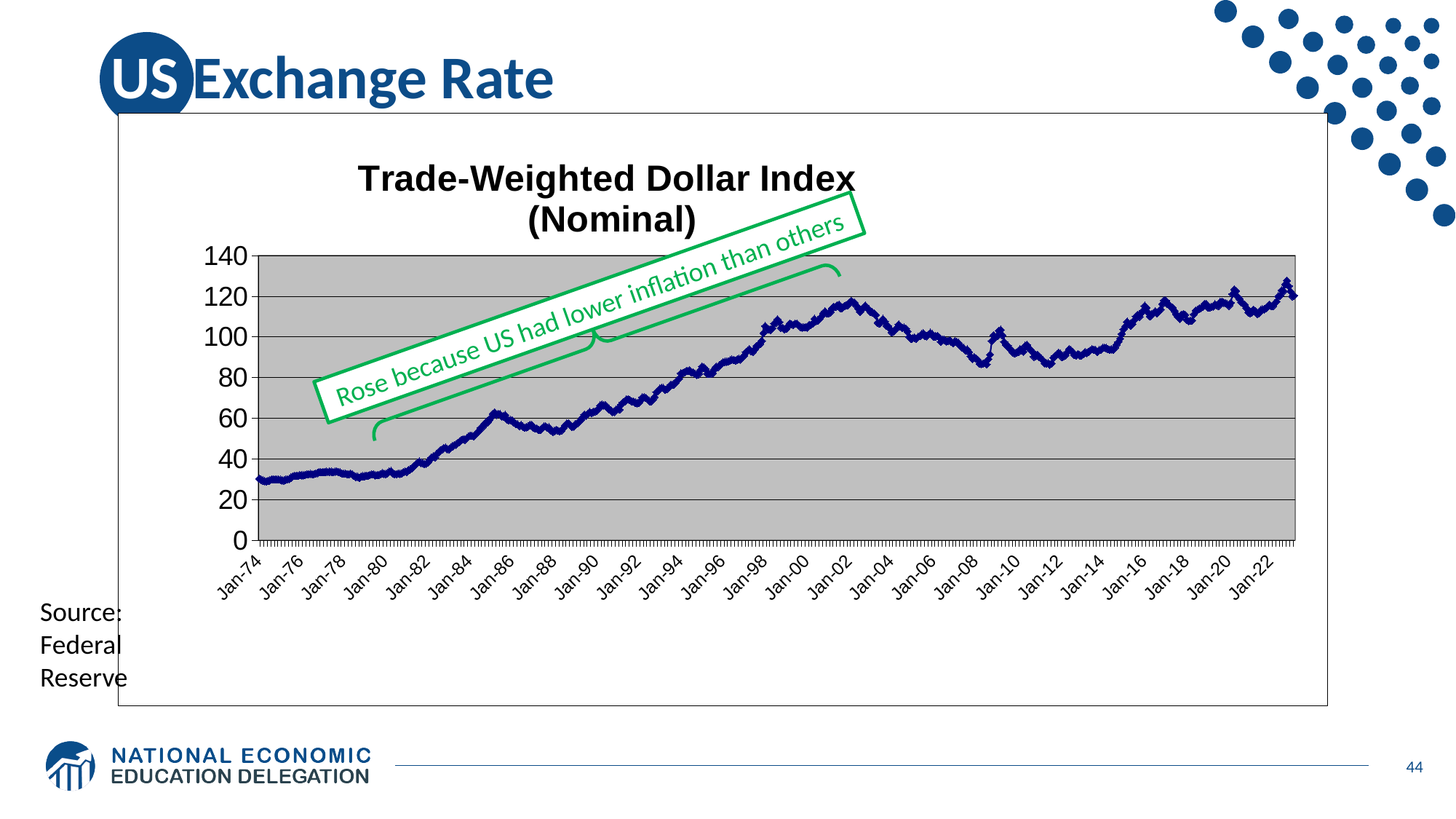
Is the value of the index at Jan-02 greater or less than 100? greater How many date labels are shown on the x axis? 25 What does the green annotation on the chart say? Rose because US had lower inflation than others What is the title of the chart? Trade-Weighted Dollar Index (Nominal) Is the value of the index at Jan-74 greater or less than 40? less Overall, does the Trade-Weighted Dollar Index rise or fall from Jan-74 to the end of the series? Rise What kind of chart is shown on the slide? Line chart Is the value of the index at Jan-80 greater or less than 60? less What is the highest value shown on the y axis? 140 Which is larger, the index value at Jan-74 or at Jan-02? Jan-02 Which is larger, the index value at Jan-02 or at Jan-12? Jan-02